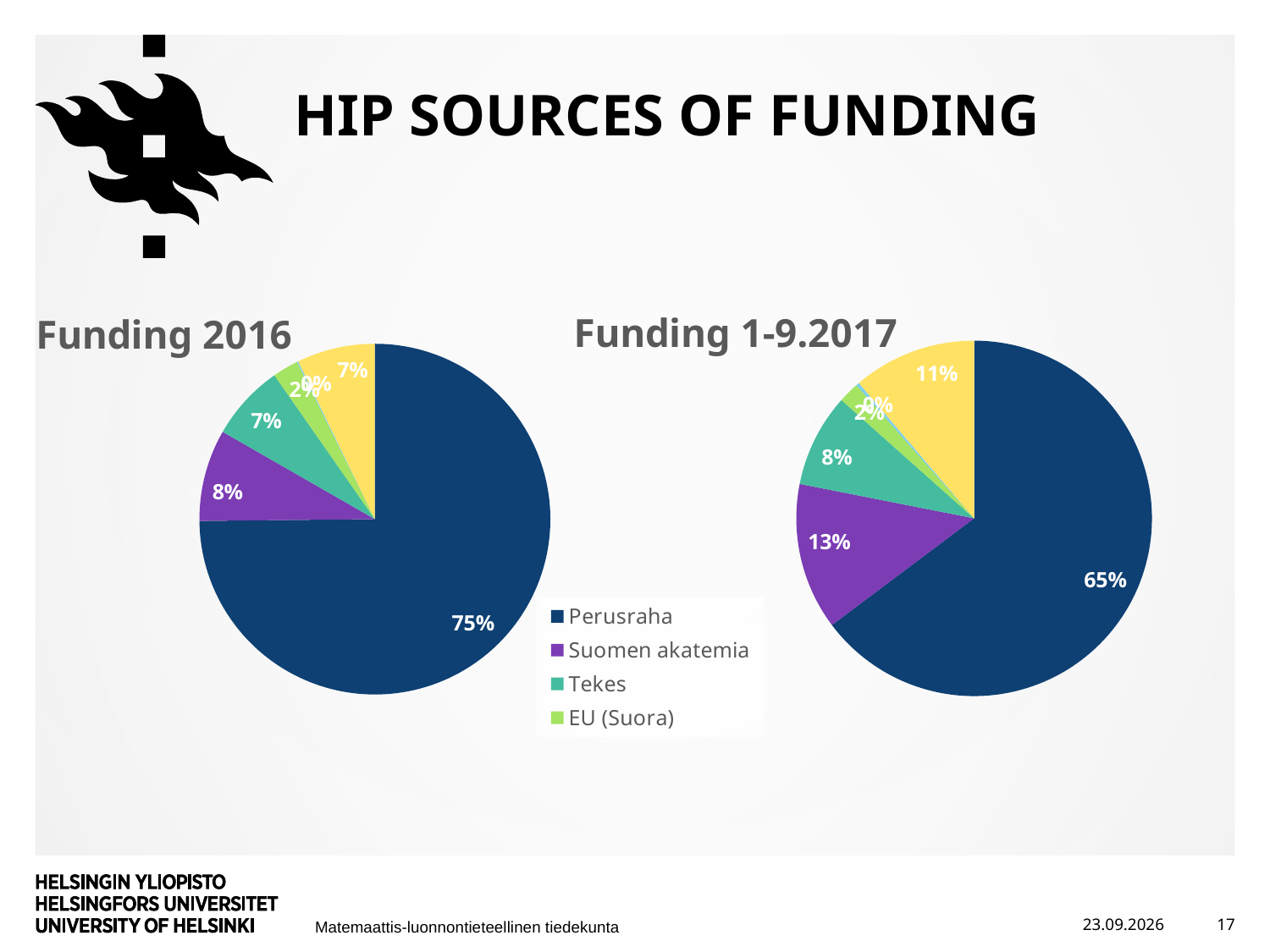
In the Funding 1-9.2017 chart, what share does Suomen akatemia have? 13% In the legend, what colour represents Perusraha? Dark blue Is the share of Suomen akatemia larger in the Funding 2016 chart or the Funding 1-9.2017 chart? Funding 1-9.2017 In the Funding 2016 chart, what share does Tekes have? 7% In the Funding 1-9.2017 chart, what share does Perusraha have? 65% In the Funding 2016 chart, which funding source has the largest share? Perusraha By how many percentage points is the Suomen akatemia share in the Funding 1-9.2017 chart larger than in the Funding 2016 chart? 5 percentage points In the Funding 1-9.2017 chart, what share does Tekes have? 8% What kind of chart is used for Funding 2016? Pie chart By how many percentage points is the Perusraha share in the Funding 2016 chart larger than in the Funding 1-9.2017 chart? 10 percentage points In the Funding 2016 chart, what share does Perusraha have? 75% In the Funding 2016 chart, what share does EU (Suora) have? 2%